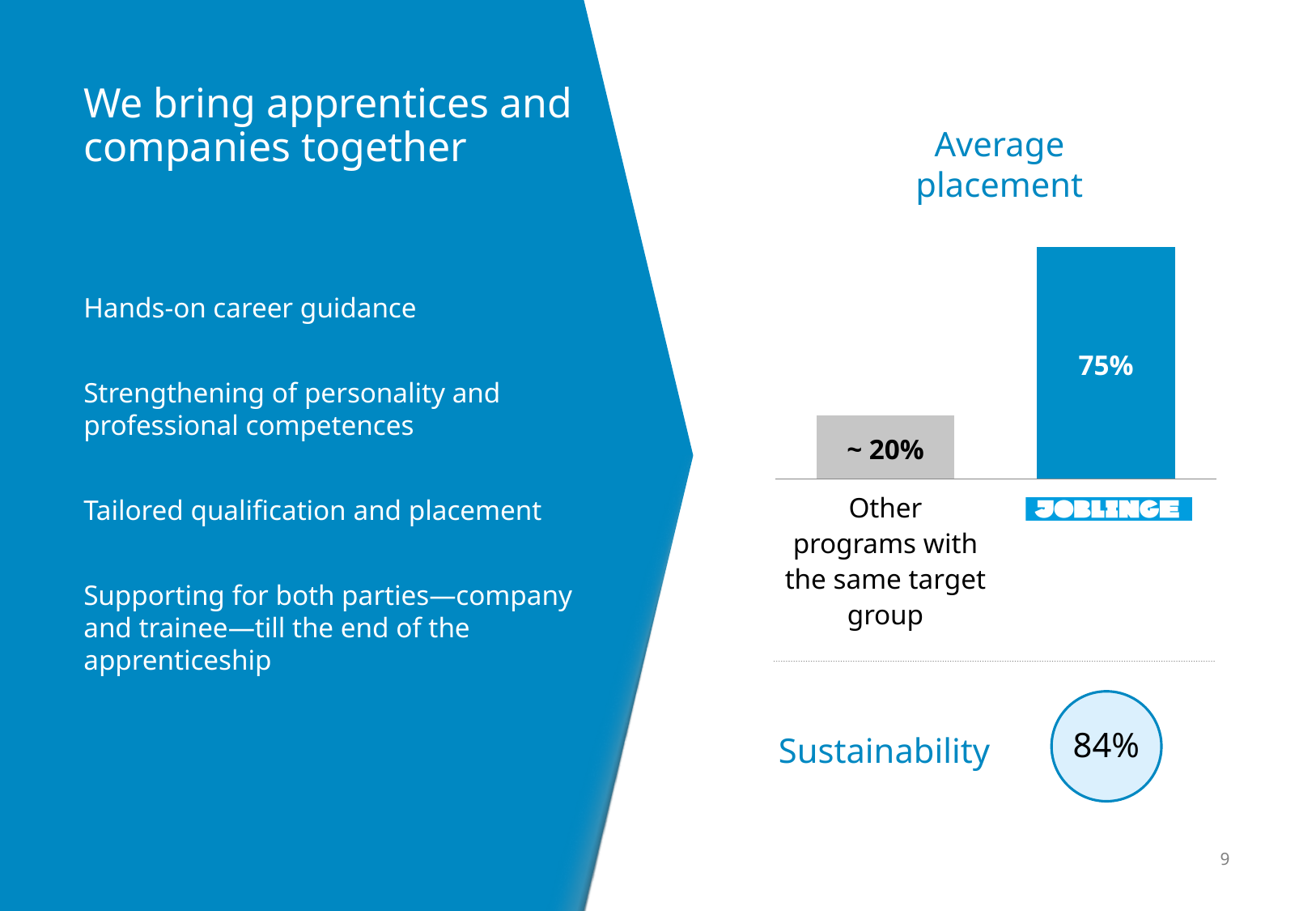
How many bars are shown in the Average placement chart? 2 What kind of chart is used to show average placement? Bar chart In the Average placement chart, what value is shown for other programs with the same target group? ~ 20% In the Average placement chart, what is the value for JOBLINGE? 75% In the Average placement chart, which is larger: JOBLINGE or other programs with the same target group? JOBLINGE In the Average placement chart, which category has the lowest value? Other programs with the same target group What is the title of the chart on the slide? Average placement In the Average placement chart, what colour is the JOBLINGE bar? Blue In the Average placement chart, which category has the highest value? JOBLINGE